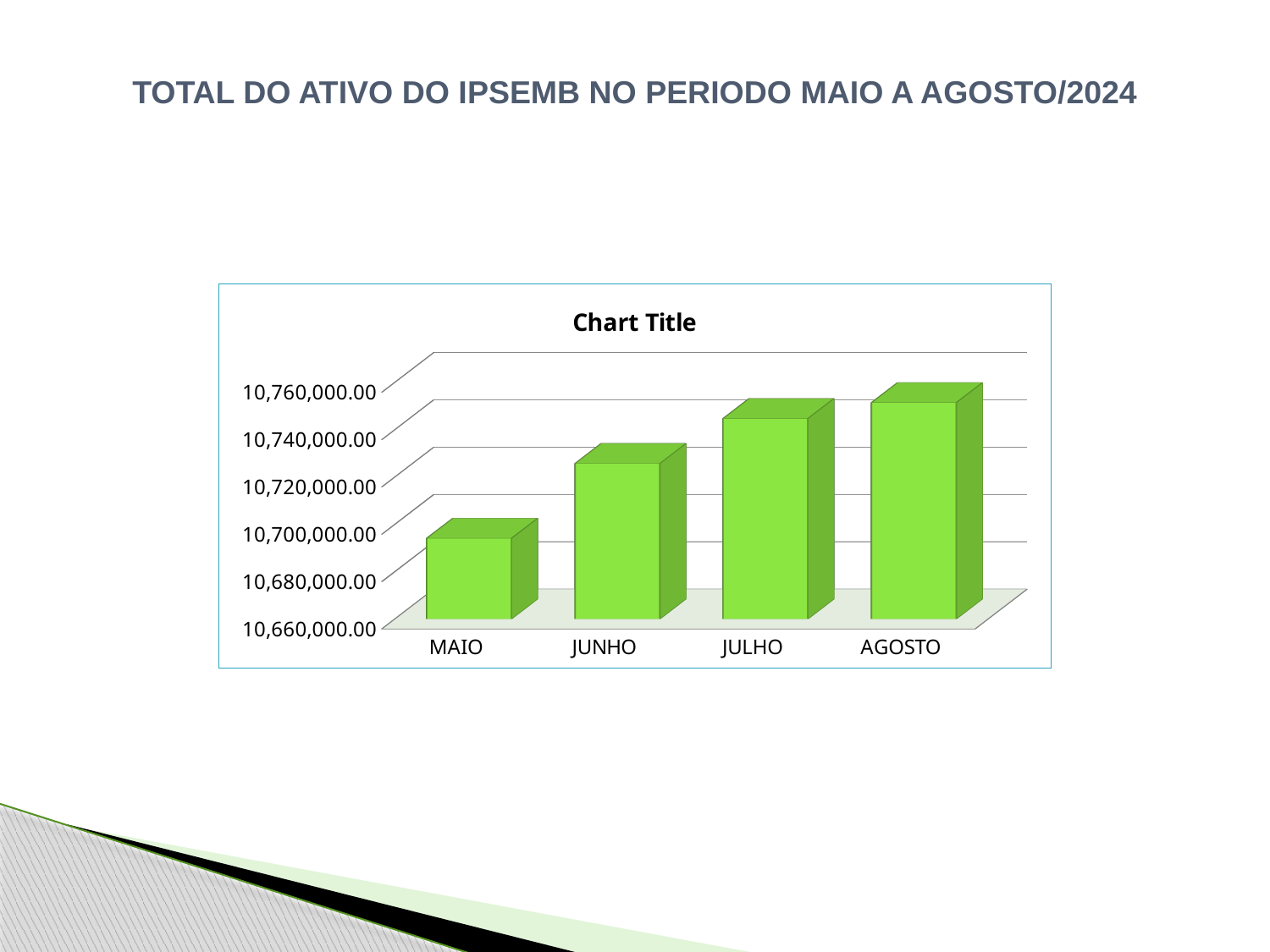
Which is larger, the value for JULHO or the value for JUNHO? JULHO Is the value for MAIO greater or less than 10,680,000.00? greater Which month has the lowest value in the chart? MAIO Is the value for AGOSTO greater or less than 10,760,000.00? less How many months are shown on the x axis of the chart? 4 What title is printed above the chart's plot area? Chart Title Which is larger, the value for JUNHO or the value for MAIO? JUNHO Is the value for JUNHO greater or less than 10,740,000.00? less Which month has the highest value in the chart? AGOSTO What kind of chart is shown on the slide? bar chart Do the values rise or fall from MAIO to AGOSTO? rise